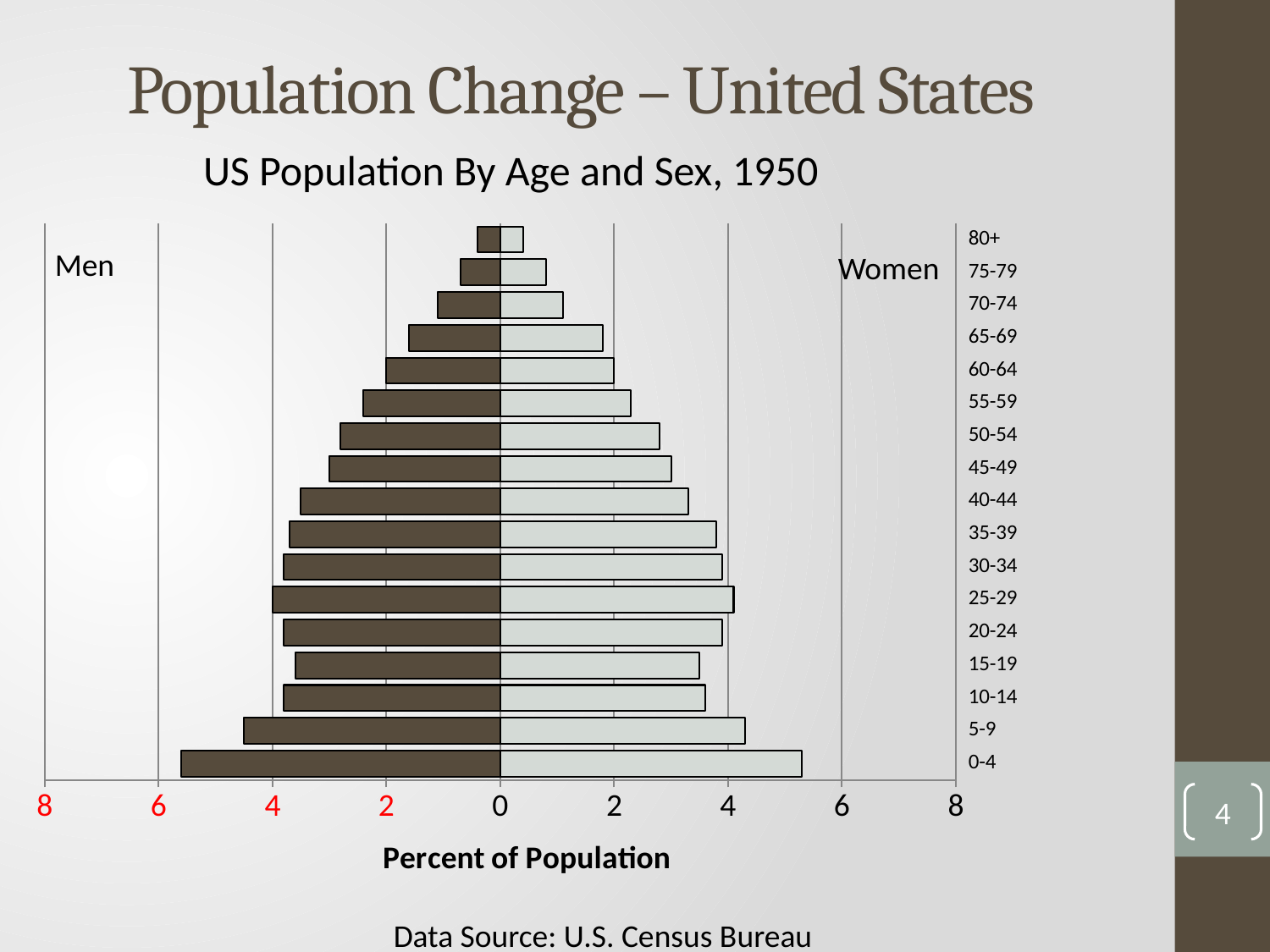
Is the value for men aged 40-44 greater or less than 4? less What is the title of the chart? US Population By Age and Sex, 1950 What is the label on the horizontal axis of the chart? Percent of Population Which age group has the lowest percentage of population for women? 80+ What kind of chart is shown on the slide? bar chart How many series (sexes) does the chart show? 2 Is the value for men aged 80+ greater or less than 2? less Which age group has the highest percentage of population for men? 0-4 Is the value for women aged 0-4 greater or less than 4? greater How many age groups are shown in the chart? 17 For the 0-4 age group, which is larger, the men's value or the women's value? men